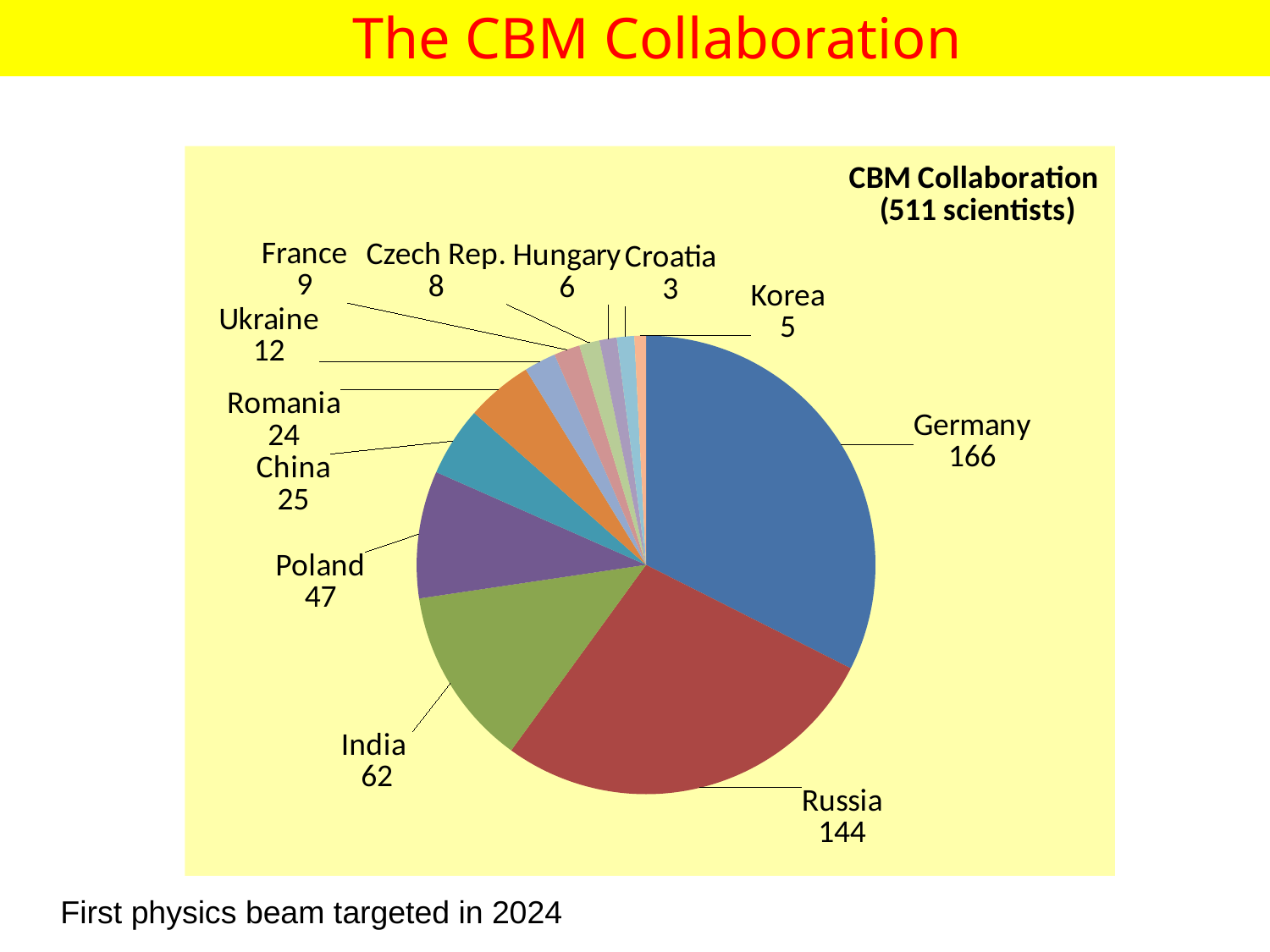
What is the value shown for Russia? 144 How many scientists from Germany are shown in the pie chart? 166 What is the difference between the values for Germany and Russia? 22 What share of the 511 scientists does Germany account for, to the nearest whole percent? 32% What is the value shown for Czech Rep.? 8 Which country has the largest slice of the pie? Germany Which has a larger value, India or Poland? India How many countries are shown in the pie chart? 12 What type of chart is shown on the slide? pie chart What is the total number of scientists stated in the chart title? 511 Which country has the smallest slice of the pie? Croatia What is the value shown for Poland? 47